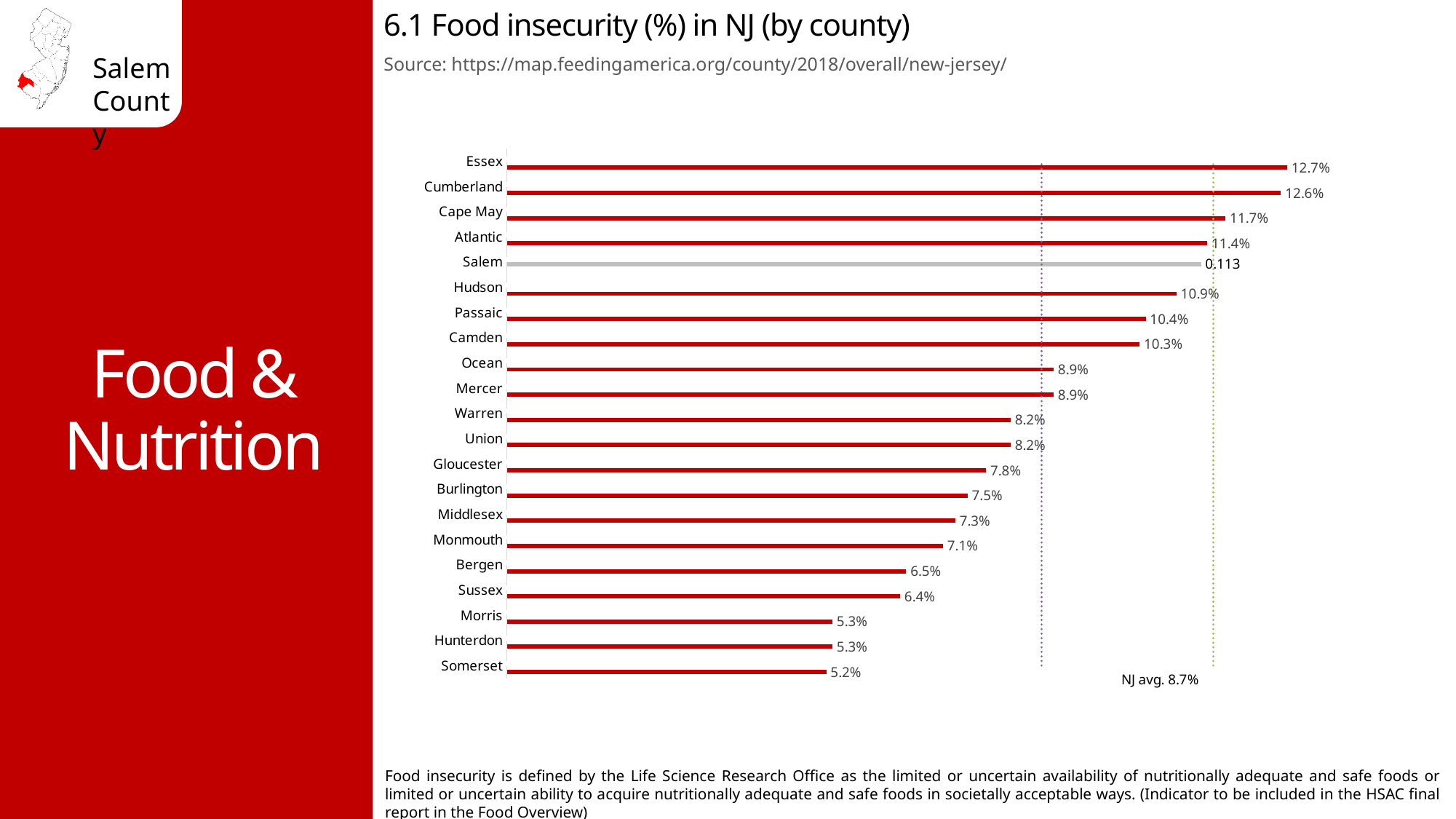
Which has a higher food insecurity value, Cumberland or Cape May? Cumberland What is the food insecurity value shown for Essex? 12.7% What is the difference between the values for Essex and Somerset? 7.5 percentage points Which county has the highest food insecurity value? Essex Do the values rise or fall going from the top of the chart to the bottom? fall What NJ average value is noted on the chart? 8.7% What is the food insecurity value shown for Gloucester? 7.8% What value is printed next to the bar for Salem? 0.113 How many counties are shown in the chart? 21 Which county has the lowest food insecurity value? Somerset What type of chart is shown on the slide? bar chart What is the difference between the values for Hudson and Camden? 0.6 percentage points